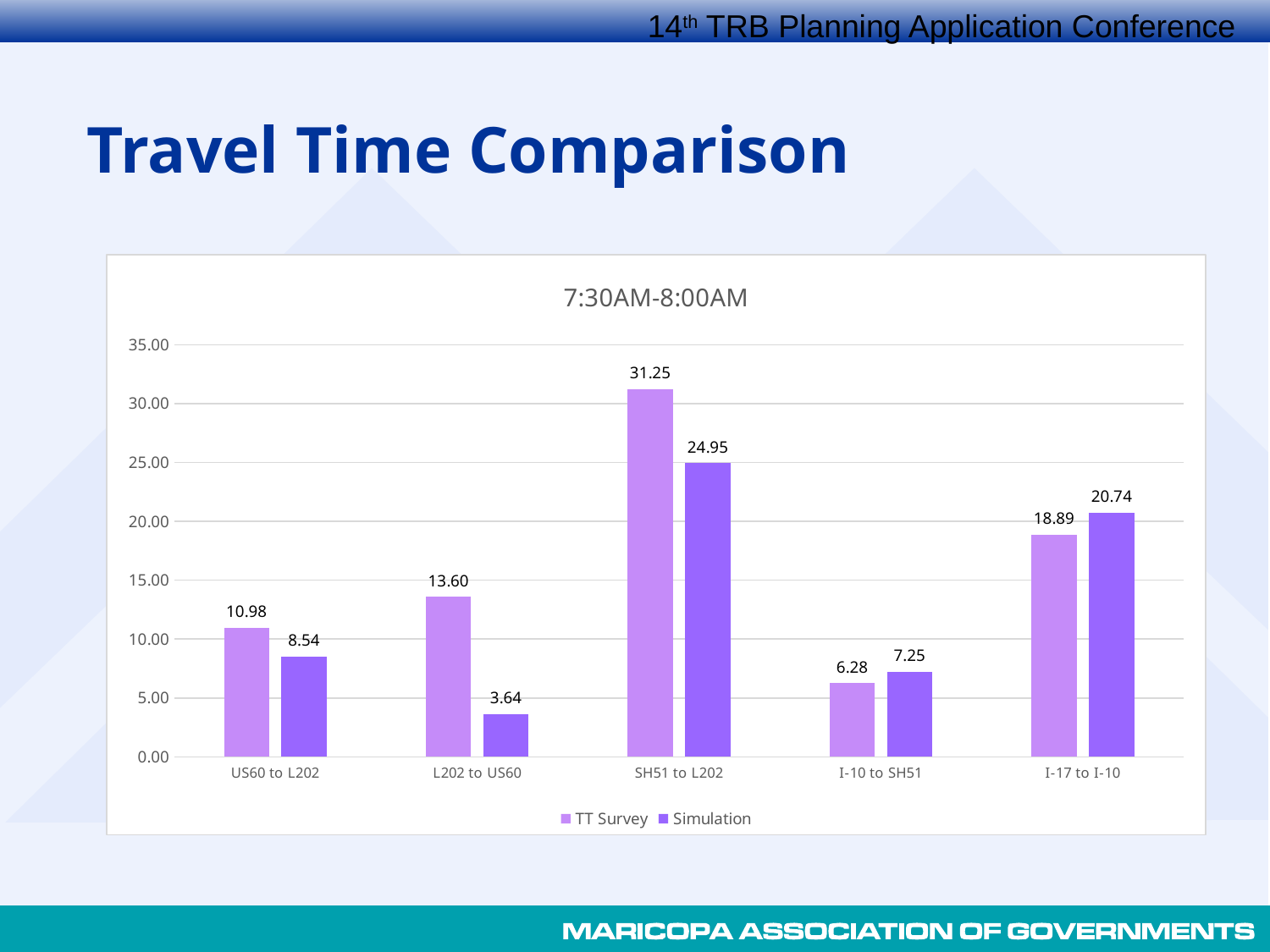
What is the difference between the TT Survey and Simulation values for US60 to L202? 2.44 For I-10 to SH51, which is larger: the TT Survey value or the Simulation value? Simulation How many series does the legend list? 2 What type of chart is shown on the slide? Bar chart What is the TT Survey value for SH51 to L202? 31.25 Is the TT Survey value for I-17 to I-10 greater or less than 20.00? less What is the Simulation value for L202 to US60? 3.64 Which category has the lowest Simulation value? L202 to US60 How many categories are shown on the x axis? 5 What is the Simulation value for I-17 to I-10? 20.74 Which category has the highest TT Survey value? SH51 to L202 What is the difference between the TT Survey and Simulation values for SH51 to L202? 6.30